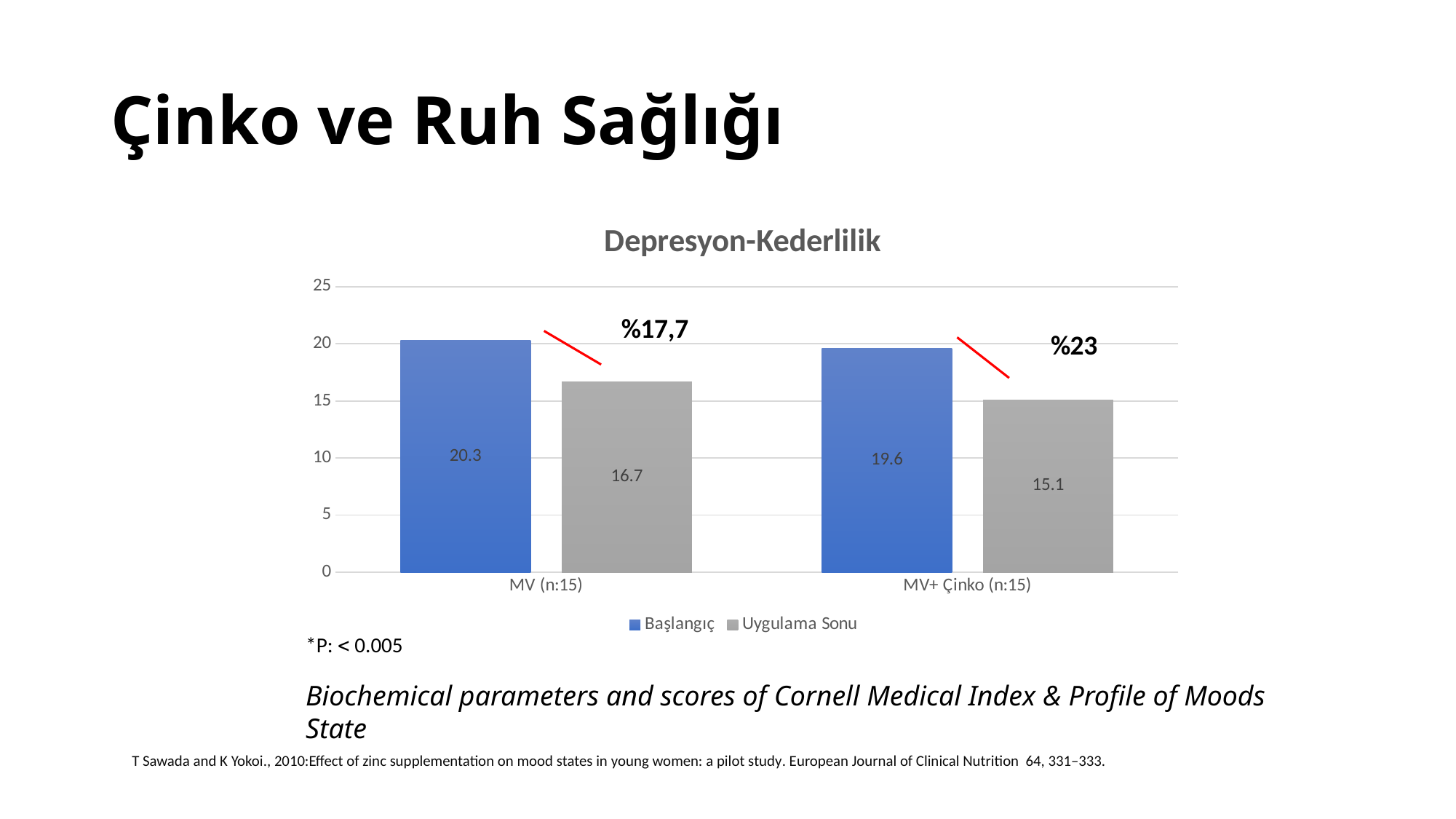
What is the Başlangıç value for MV+ Çinko (n:15)? 19.6 Which bar has the highest value in the chart? Başlangıç for MV (n:15) How many categories are shown on the x axis? 2 What is the title of the chart? Depresyon-Kederlilik Which is larger: the Uygulama Sonu value for MV (n:15) or for MV+ Çinko (n:15)? MV (n:15) What is the Başlangıç value for MV (n:15)? 20.3 What is the Uygulama Sonu value for MV+ Çinko (n:15)? 15.1 How many series does the legend list? 2 What is the difference between the Başlangıç and Uygulama Sonu values for MV+ Çinko (n:15)? 4.5 What kind of chart is shown on the slide? Bar chart Which bar has the lowest value in the chart? Uygulama Sonu for MV+ Çinko (n:15) What is the Uygulama Sonu value for MV (n:15)? 16.7